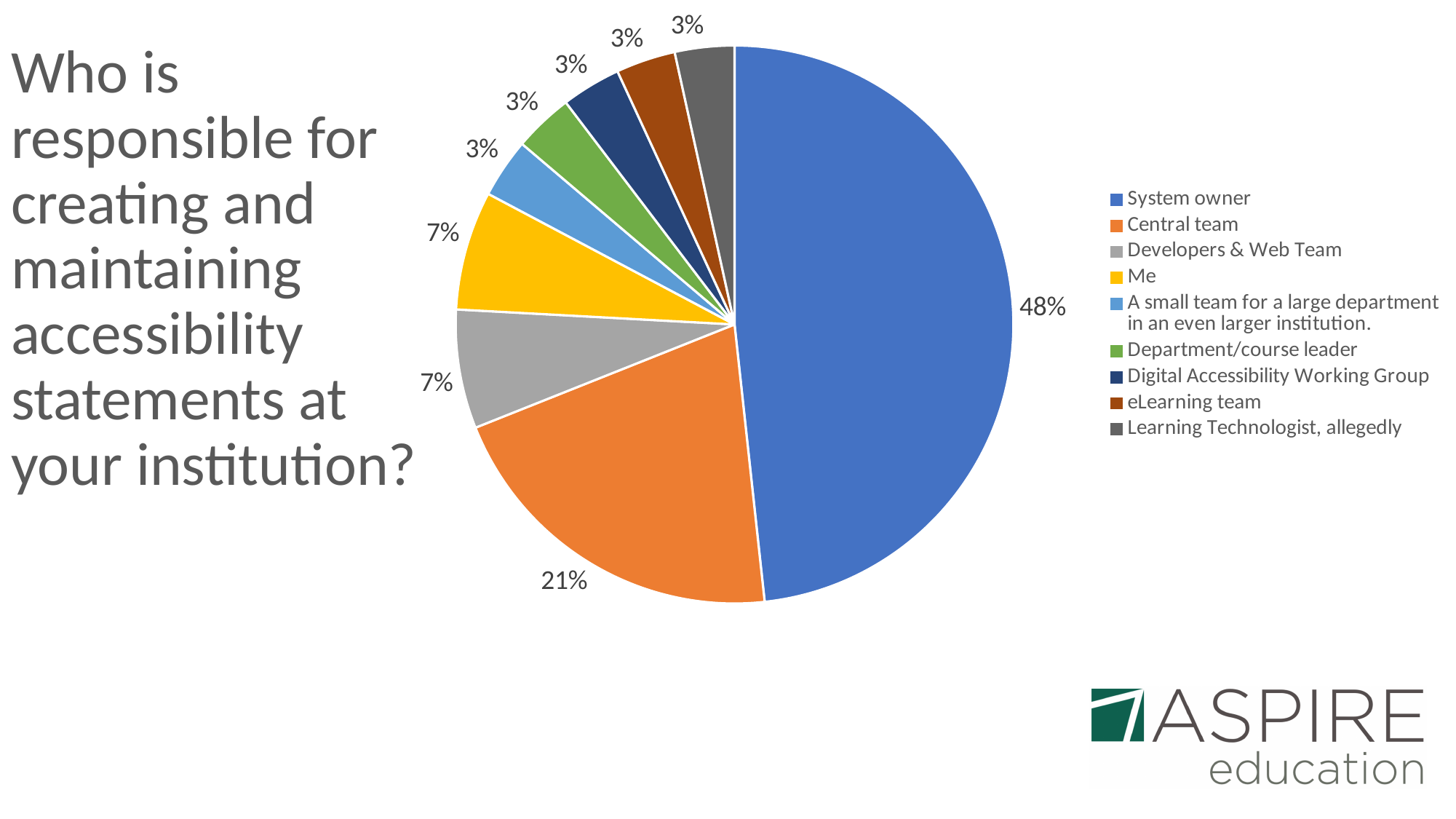
What is the difference between the shares for System owner and Central team? 27% Which category has the largest slice of the pie? System owner What share of the pie does System owner have? 48% What share of the pie does Me have? 7% What colour is the slice for Me? Yellow What share of the pie does eLearning team have? 3% What kind of chart is shown on the slide? Pie chart Which is larger, the share for Central team or the share for Me? Central team How many categories have a share of 3%? 5 How many categories does the legend list? 9